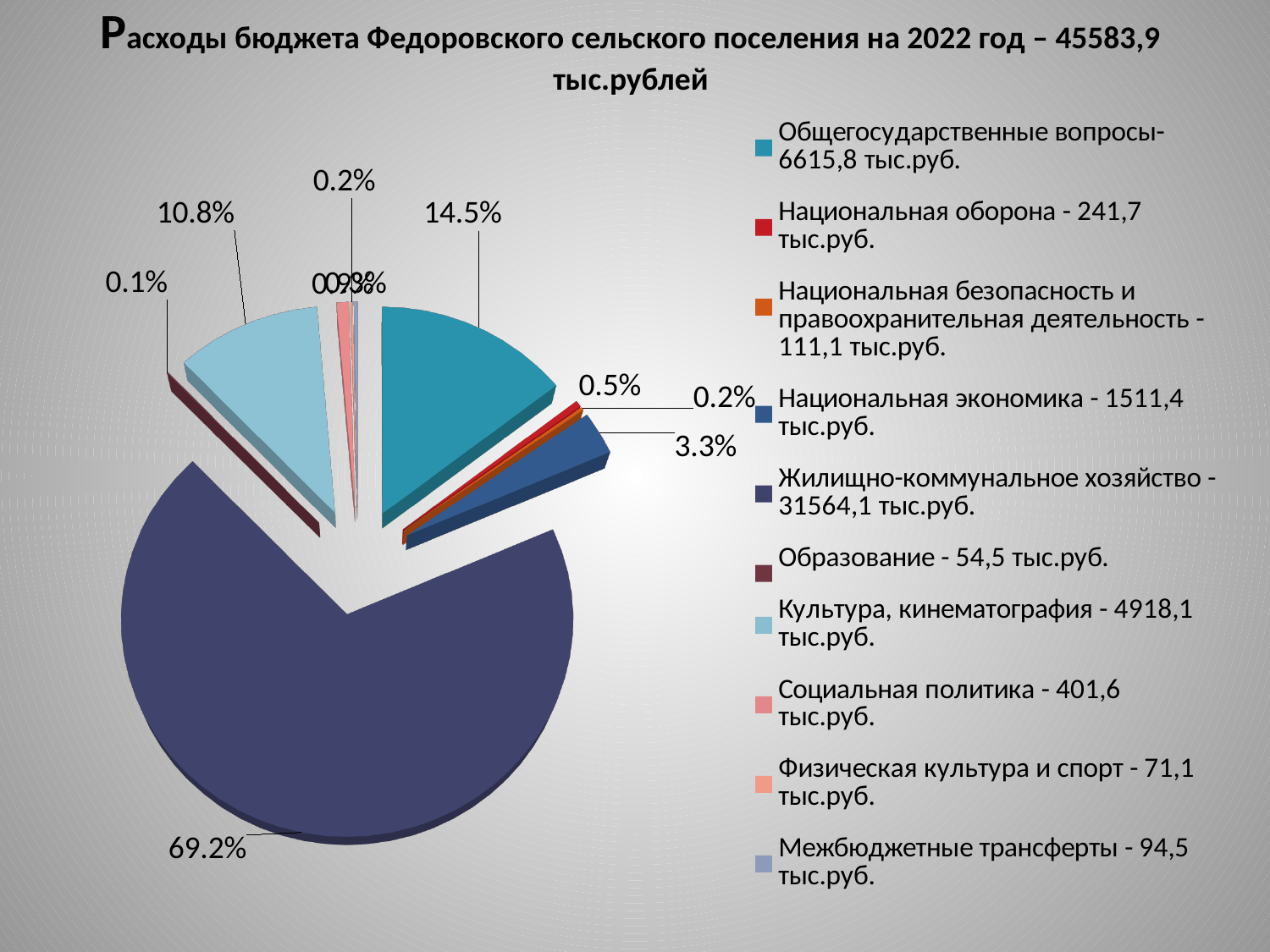
What share of the pie does Культура, кинематография take? 10.8% What total budget amount is stated in the chart title? 45583,9 тыс.рублей What kind of chart is shown on the slide? pie chart According to the legend, what is the amount for Культура, кинематография? 4918,1 тыс.руб. Which is larger: the share for Общегосударственные вопросы or the share for Культура, кинематография? Общегосударственные вопросы According to the legend, what is the amount for Национальная оборона? 241,7 тыс.руб. What share of the pie does Жилищно-коммунальное хозяйство take? 69.2% What share of the pie does Национальная экономика take? 3.3% What is the difference in percentage points between the share for Жилищно-коммунальное хозяйство and the share for Общегосударственные вопросы? 54.7 Which category has the largest slice of the pie? Жилищно-коммунальное хозяйство How many categories does the legend of the pie chart list? 10